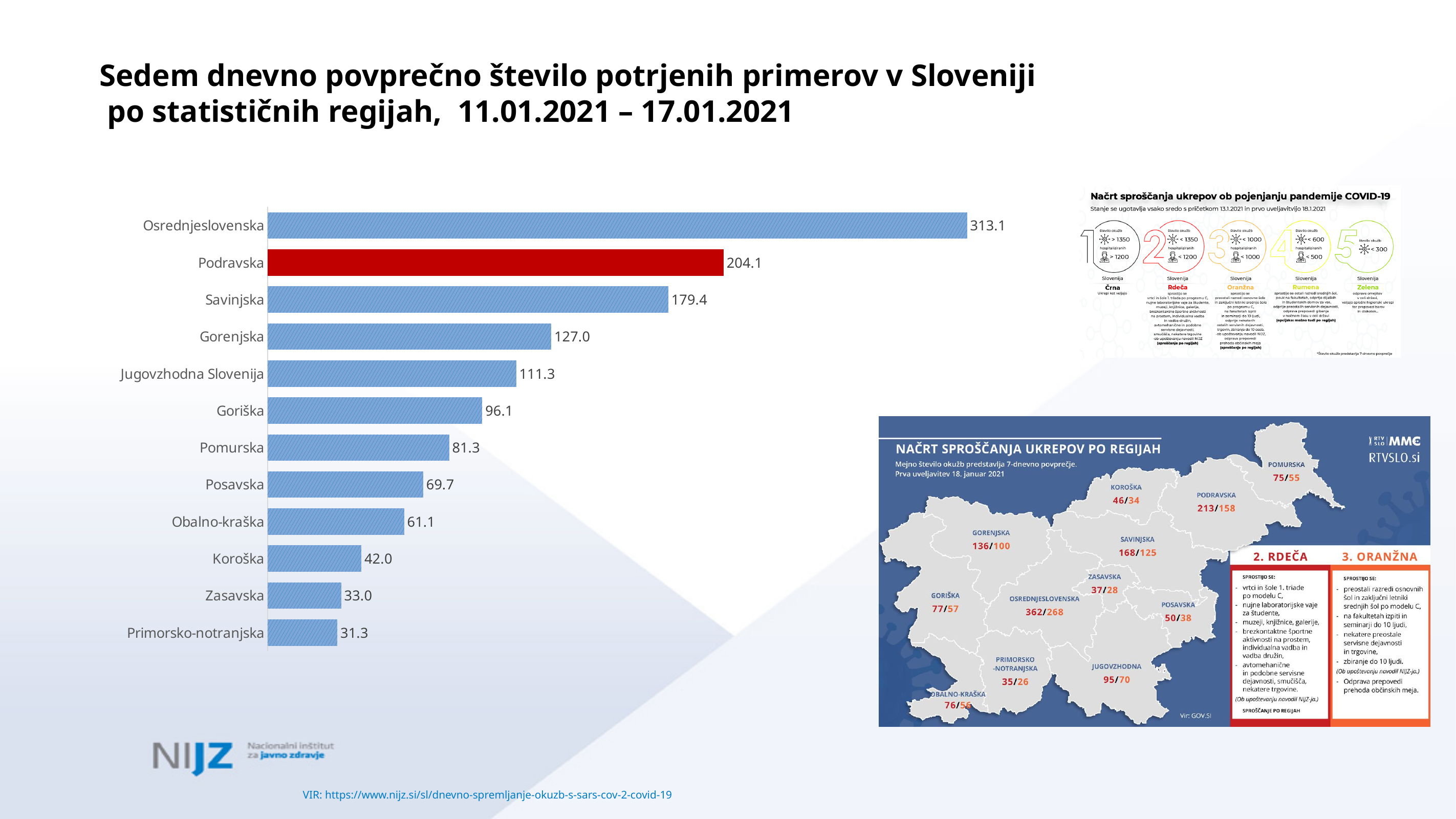
What is the difference between the values for Osrednjeslovenska and Podravska? 109.0 Which region has the lowest value? Primorsko-notranjska What is the value for Koroška? 42.0 Which region has the highest value? Osrednjeslovenska How many regions are shown in the bar chart? 12 What is the value for Gorenjska? 127.0 Which region's bar is coloured red instead of blue? Podravska What is the value for Jugovzhodna Slovenija? 111.3 Which is larger, the value for Pomurska or the value for Posavska? Pomurska What kind of chart is shown on the slide? bar chart What is the difference between the values for Savinjska and Gorenjska? 52.4 What is the value for Podravska? 204.1